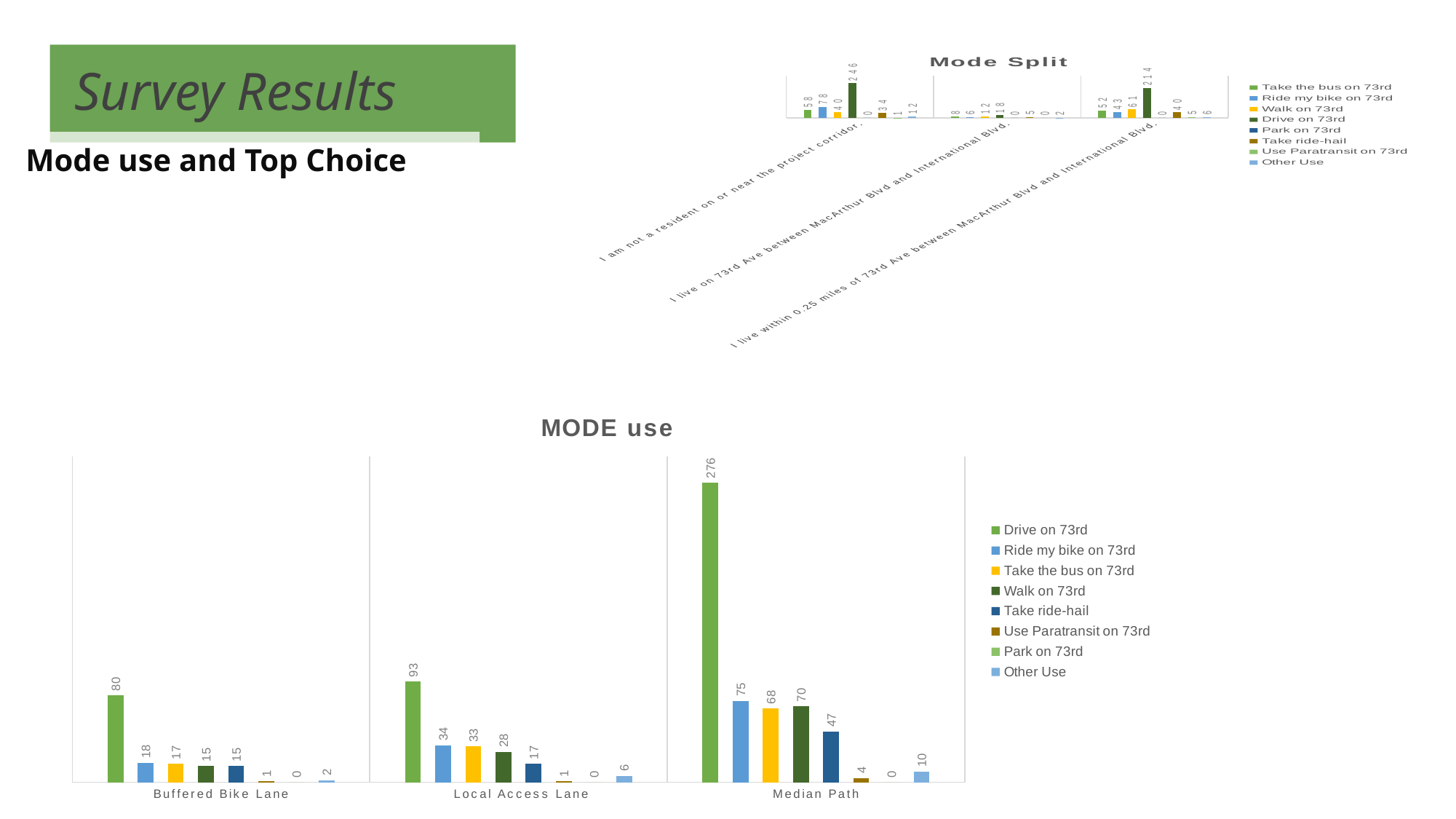
In the MODE use chart, which series has the lowest value in the Median Path category? Park on 73rd How many series does the legend of the MODE use chart list? 8 In the MODE use chart, what is the value for Take the bus on 73rd in the Local Access Lane category? 33 In the MODE use chart, which is larger in the Median Path category: Take the bus on 73rd or Walk on 73rd? Walk on 73rd In the MODE use chart, which category has the highest value for Drive on 73rd? Median Path In the MODE use chart, what is the difference between Drive on 73rd for Local Access Lane and Drive on 73rd for Buffered Bike Lane? 13 In the MODE use chart, what is the value for Drive on 73rd in the Median Path category? 276 In the MODE use chart, what is the value for Take ride-hail in the Buffered Bike Lane category? 15 What kind of chart is the MODE use chart? bar chart How many categories are shown on the x axis of the MODE use chart? 3 How many series does the legend of the Mode Split chart list? 8 What is the title of the chart in the top right of the slide? Mode Split